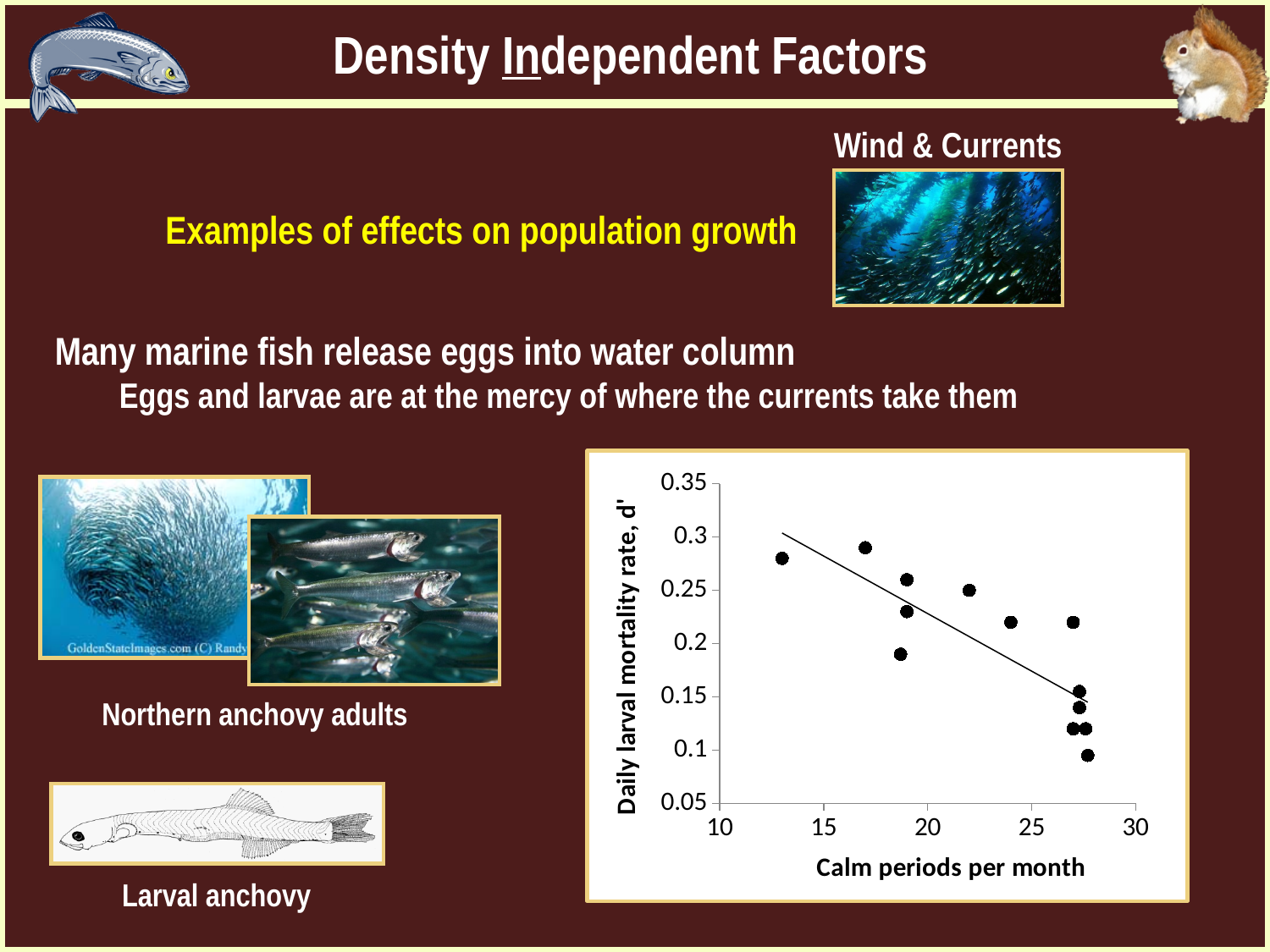
What kind of chart is shown on the slide? scatter plot Is the daily larval mortality rate for the point at about 22 calm periods per month greater or less than 0.2? greater Is the daily larval mortality rate higher at about 13 calm periods per month or at about 27 calm periods per month? 13 calm periods per month Is the daily larval mortality rate for the point at about 17 calm periods per month greater or less than 0.25? greater Is the daily larval mortality rate for the point at about 13 calm periods per month greater or less than 0.25? greater As calm periods per month increase, does the daily larval mortality rate generally rise or fall? fall What is the label of the x axis of the chart? Calm periods per month What is the label of the y axis of the chart? Daily larval mortality rate, d'